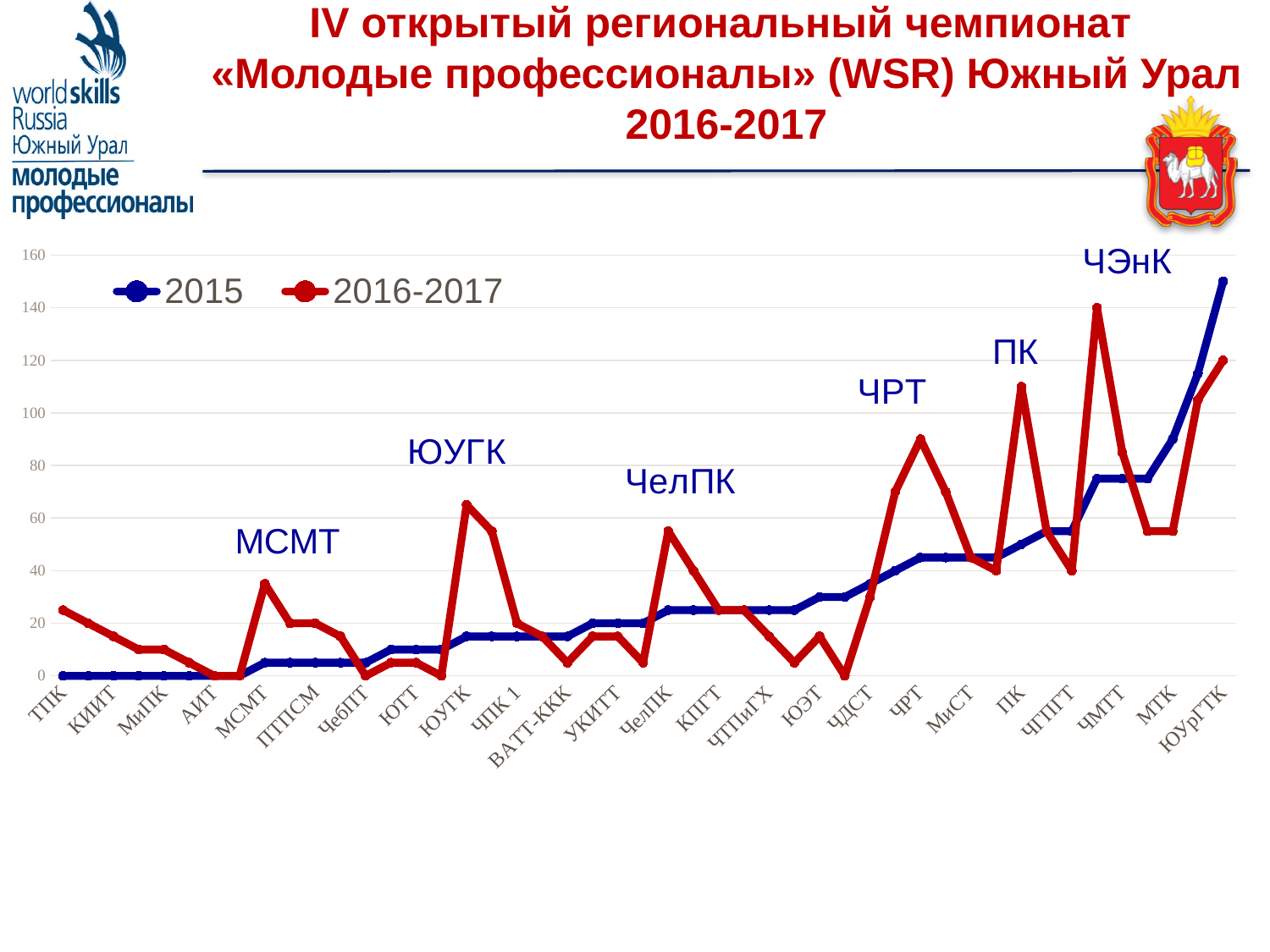
Is the 2015 value for ЮУрГТК greater or less than 140? greater At ТПК, which series has the larger value, 2015 or 2016-2017? 2016-2017 Is the 2016-2017 value for ЧМТТ greater or less than 120? less How many series does the chart legend list? 2 What are the two series named in the legend? 2015 and 2016-2017 At ЮУрГТК, which series has the larger value, 2015 or 2016-2017? 2015 Which category has the highest value in the 2016-2017 series? ЧЭнК Which category has the highest value in the 2015 series? ЮУрГТК Is the 2016-2017 value for ЧРТ greater or less than 80? greater Does the 2015 series generally rise or fall from left to right along the x axis? rise What kind of chart is shown on the slide? line chart